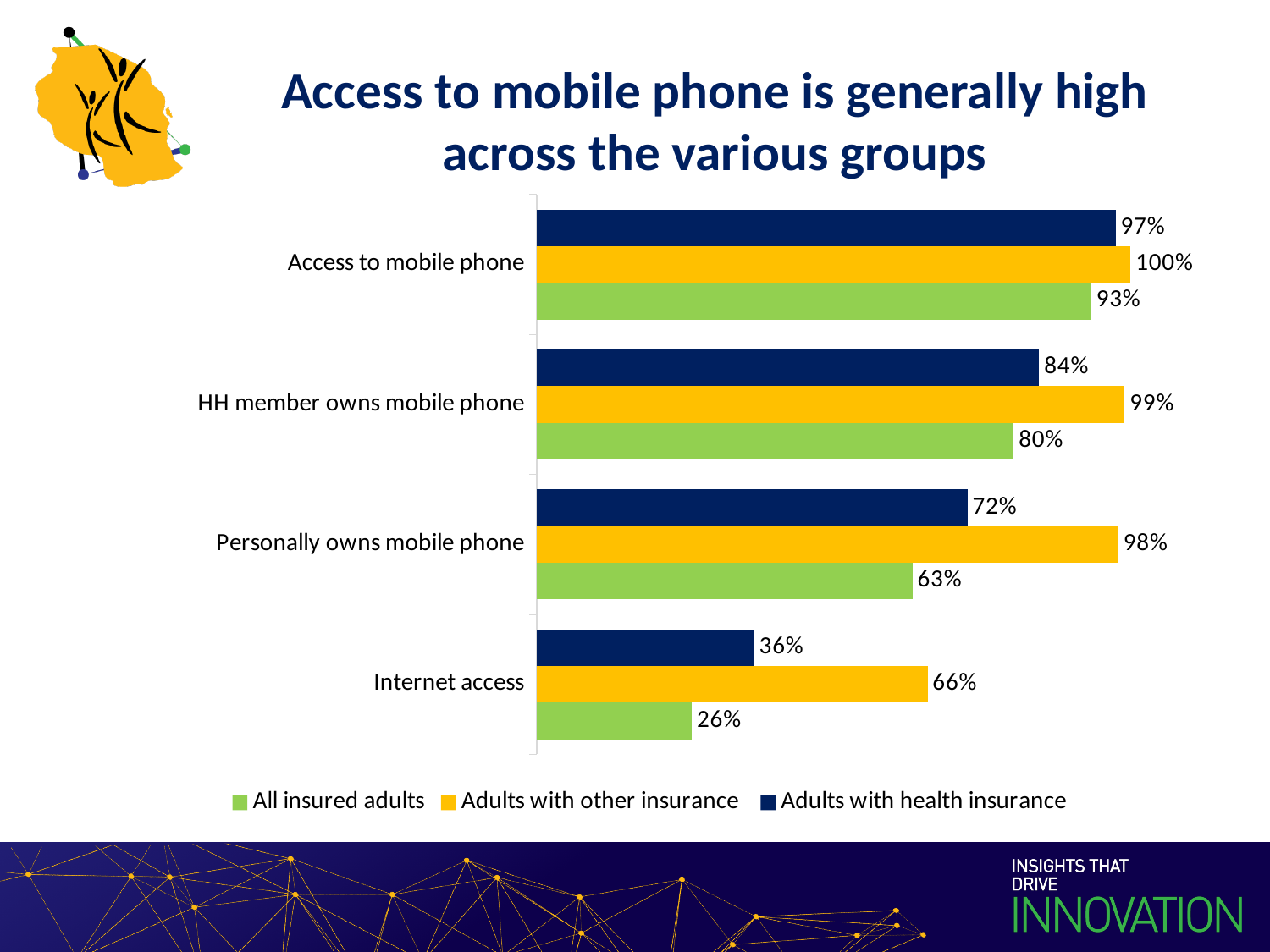
Which category has the highest value for Adults with other insurance? Access to mobile phone For HH member owns mobile phone, which is larger: Adults with health insurance or All insured adults? Adults with health insurance What is the value for All insured adults for Personally owns mobile phone? 63% What kind of chart is shown on the slide? Bar chart What is the value for Adults with health insurance for Access to mobile phone? 97% How many categories are shown on the chart? 4 What is the difference between Adults with other insurance and Adults with health insurance for Internet access? 30% What is the difference between Adults with health insurance and All insured adults for Personally owns mobile phone? 9% What is the value for All insured adults for HH member owns mobile phone? 80% What is the value for Adults with other insurance for Internet access? 66% How many series does the legend list? 3 Which category has the lowest value for All insured adults? Internet access